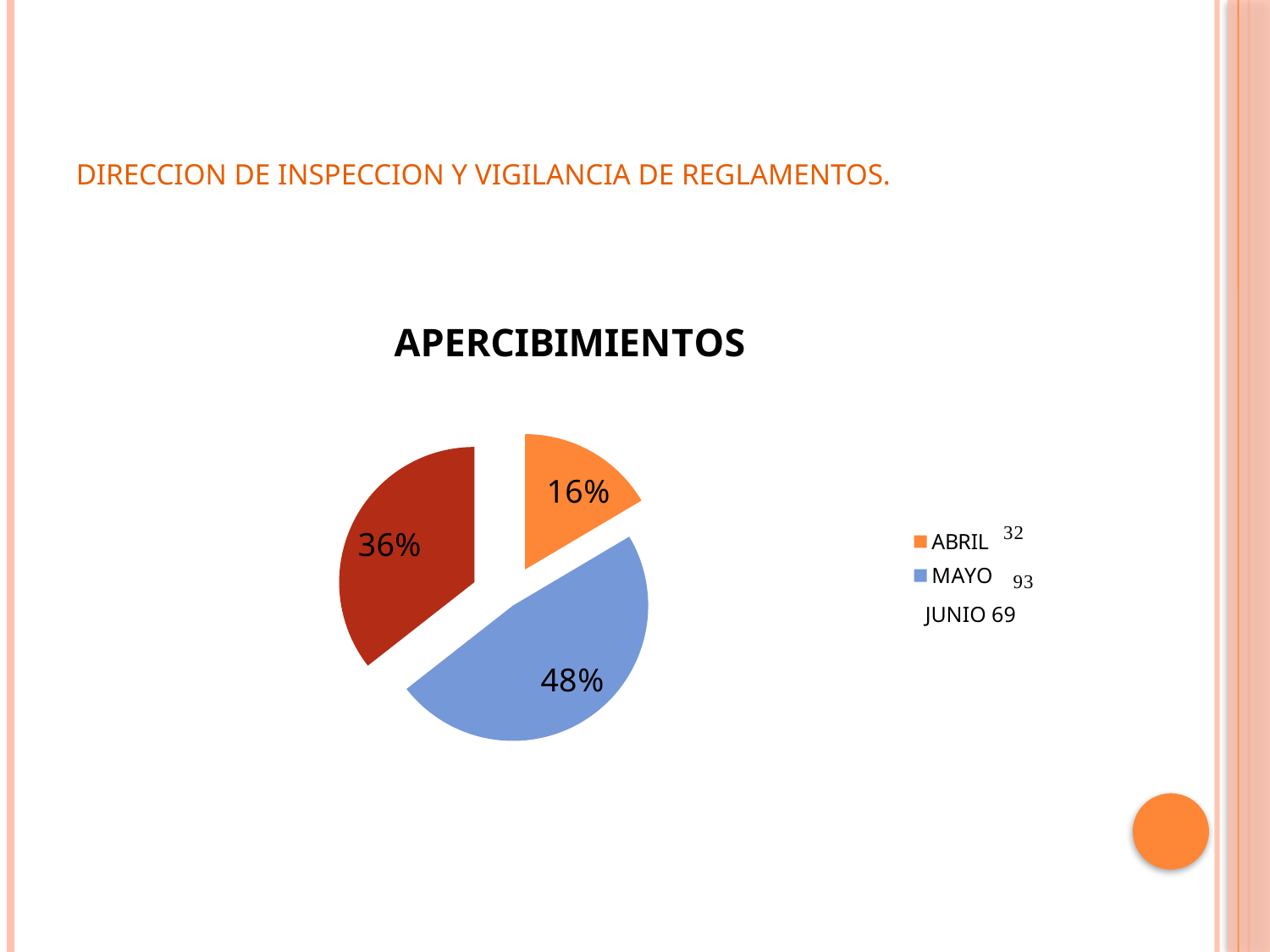
What is the difference in percentage points between the MAYO slice and the JUNIO slice? 12 What share of the pie does MAYO represent? 48% Which month has the largest slice of the pie? MAYO What share of the pie does JUNIO represent? 36% Which slice is larger, JUNIO or ABRIL? JUNIO Which month has the smallest slice of the pie? ABRIL How many slices does the pie chart have? 3 What kind of chart is shown on the slide? pie chart What colour is the slice for MAYO? blue What is the title of the chart? APERCIBIMIENTOS What share of the pie does ABRIL represent? 16% What is the difference in percentage points between the MAYO slice and the ABRIL slice? 32